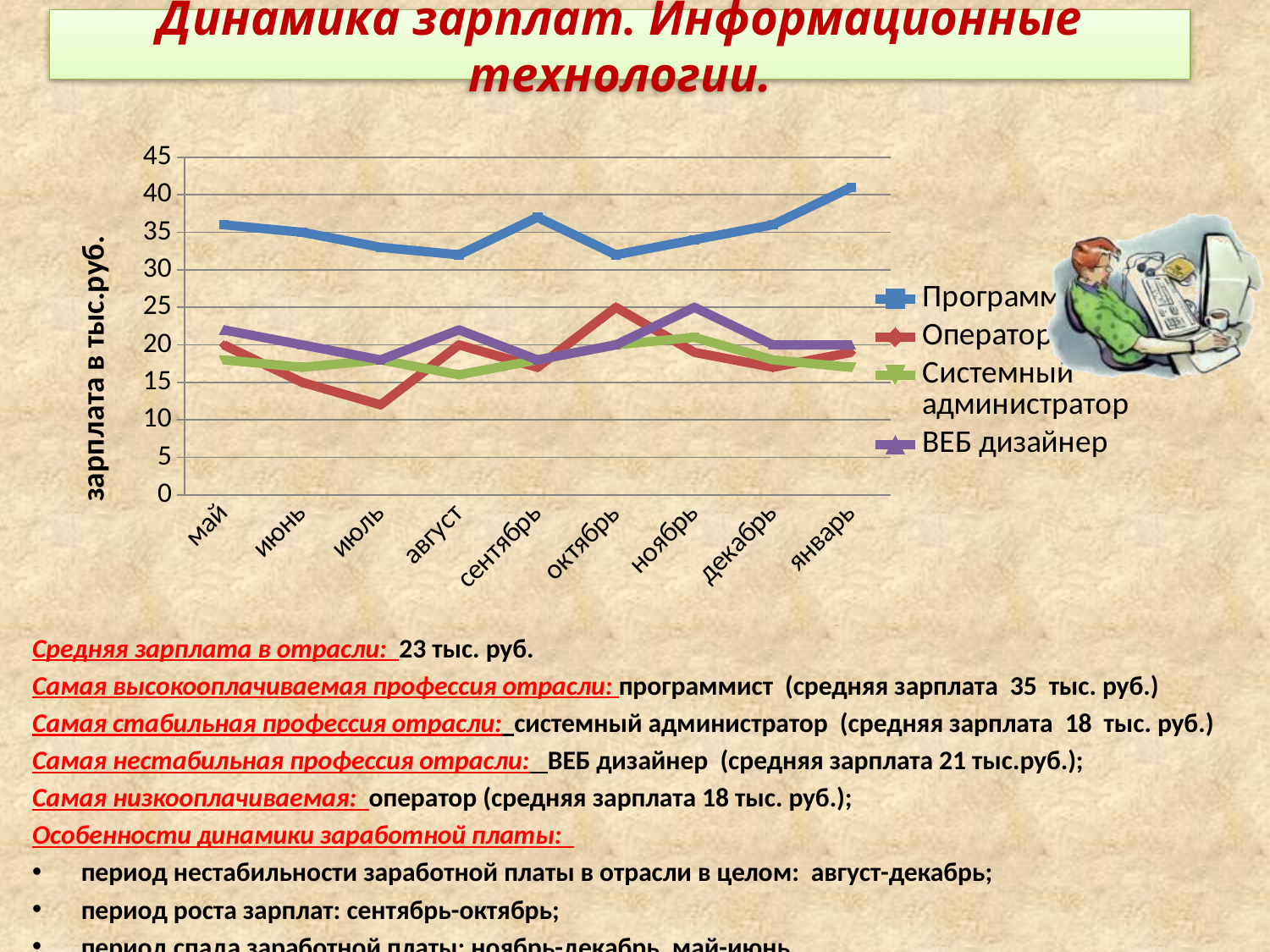
In which month does the Оператор series reach its lowest value? июль In which month does the ВЕБ дизайнер series reach its highest value? ноябрь Which series has the highest values across all months? Программист What kind of chart is shown on the slide? line chart Is the value for Оператор in июль greater or less than 15? less What is the label on the vertical axis of the chart? зарплата в тыс.руб. Is the value for Программист in январь greater or less than 35? greater Does the Программист series rise or fall from декабрь to январь? rise How many series does the legend list? 4 Is the value for Оператор in октябрь greater or less than 20? greater How many months are plotted along the x axis? 9 In январь, which is larger: the value for Программист or the value for Оператор? Программист